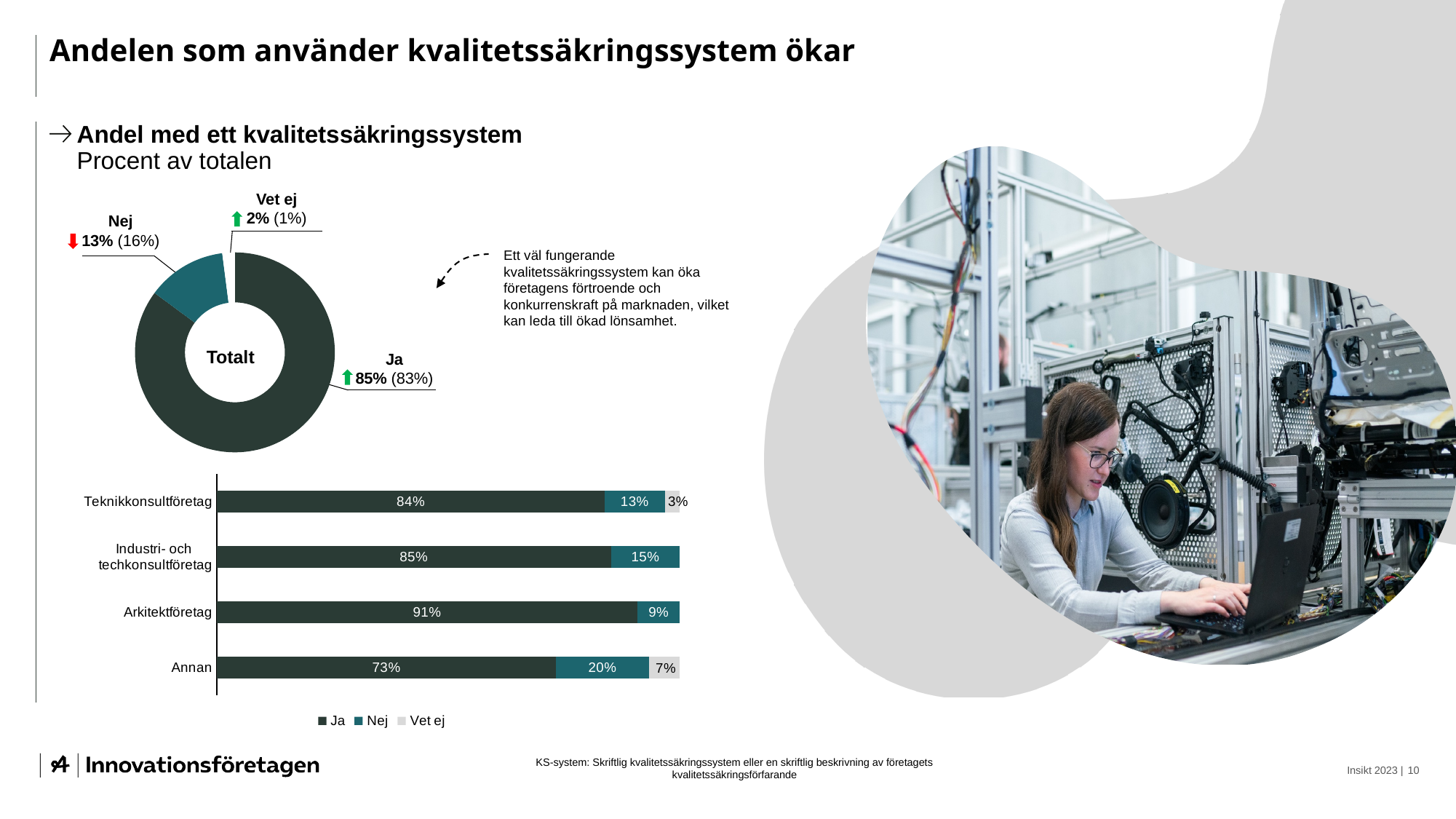
In the bar chart, what is the difference between the Ja values for Arkitektföretag and Annan? 18 percentage points In the bar chart, what is the Nej value for Annan? 20% In the donut chart, what share of the total answered Nej? 13% In the bar chart, which category has the highest Ja value? Arkitektföretag In the bar chart, what is the Ja value for Arkitektföretag? 91% What kind of chart is the lower chart on the slide? Stacked bar chart In the donut chart, which answer has the largest share? Ja In the donut chart, which answer has the smallest share? Vet ej In the donut chart, what was the previous year's share for Vet ej, shown in parentheses? 1% In the bar chart, which category has the lowest Ja value? Annan In the donut chart, what share of the total answered Ja? 85% In the bar chart, how many series does the legend list? 3